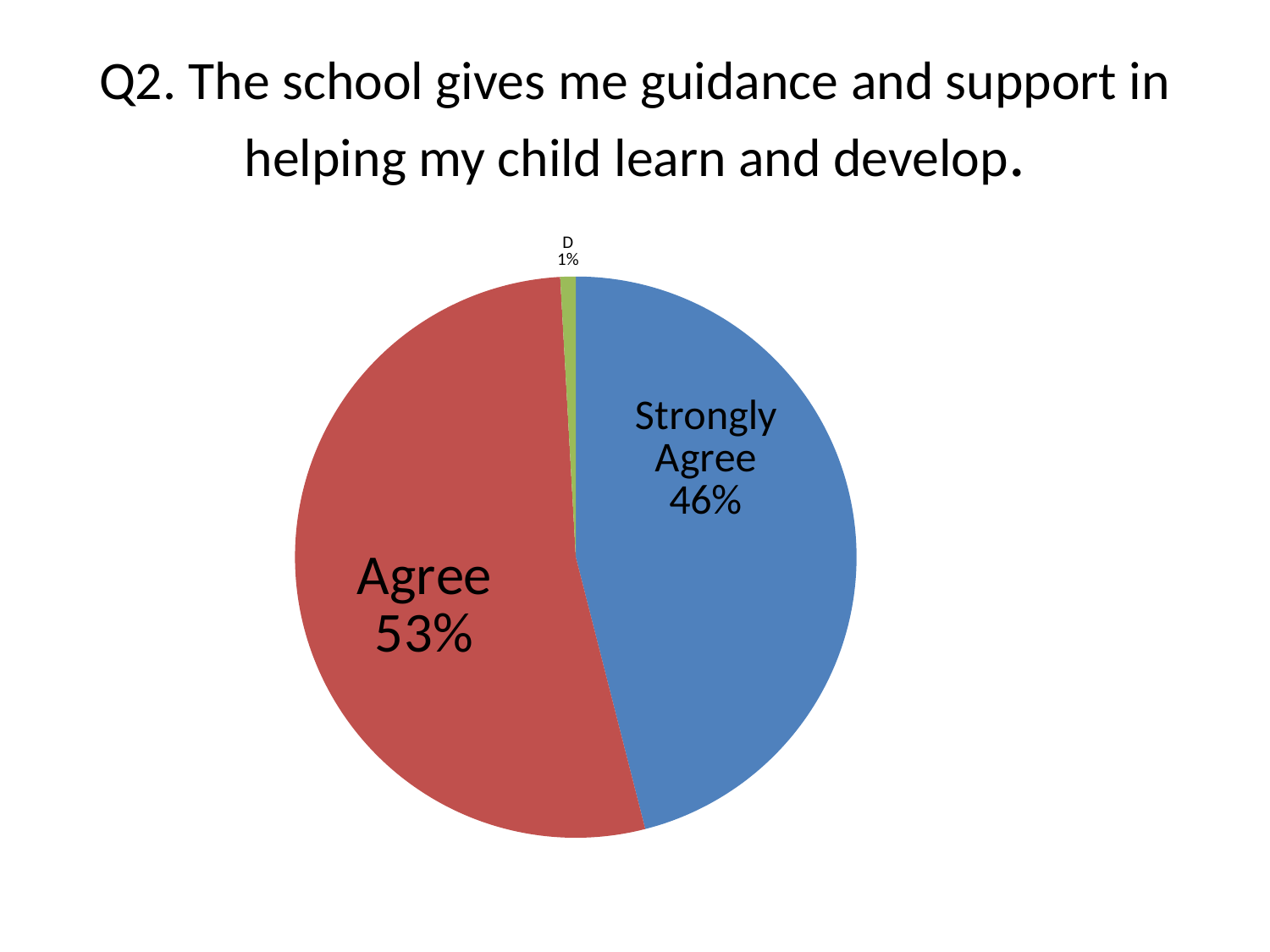
Which is larger, the Agree slice or the Strongly Agree slice? Agree What kind of chart is shown on the slide? pie chart What share of the pie is labelled D? 1% What is the title of the slide's chart? Q2. The school gives me guidance and support in helping my child learn and develop. Which slice of the pie is the smallest? D Which slice of the pie is the largest? Agree What share of the pie is labelled Agree? 53% What is the combined share of the Agree and Strongly Agree slices? 99% What is the difference in percentage points between the Agree and Strongly Agree slices? 7 How many slices does the pie chart have? 3 What colour is the Agree slice? red What share of the pie is labelled Strongly Agree? 46%